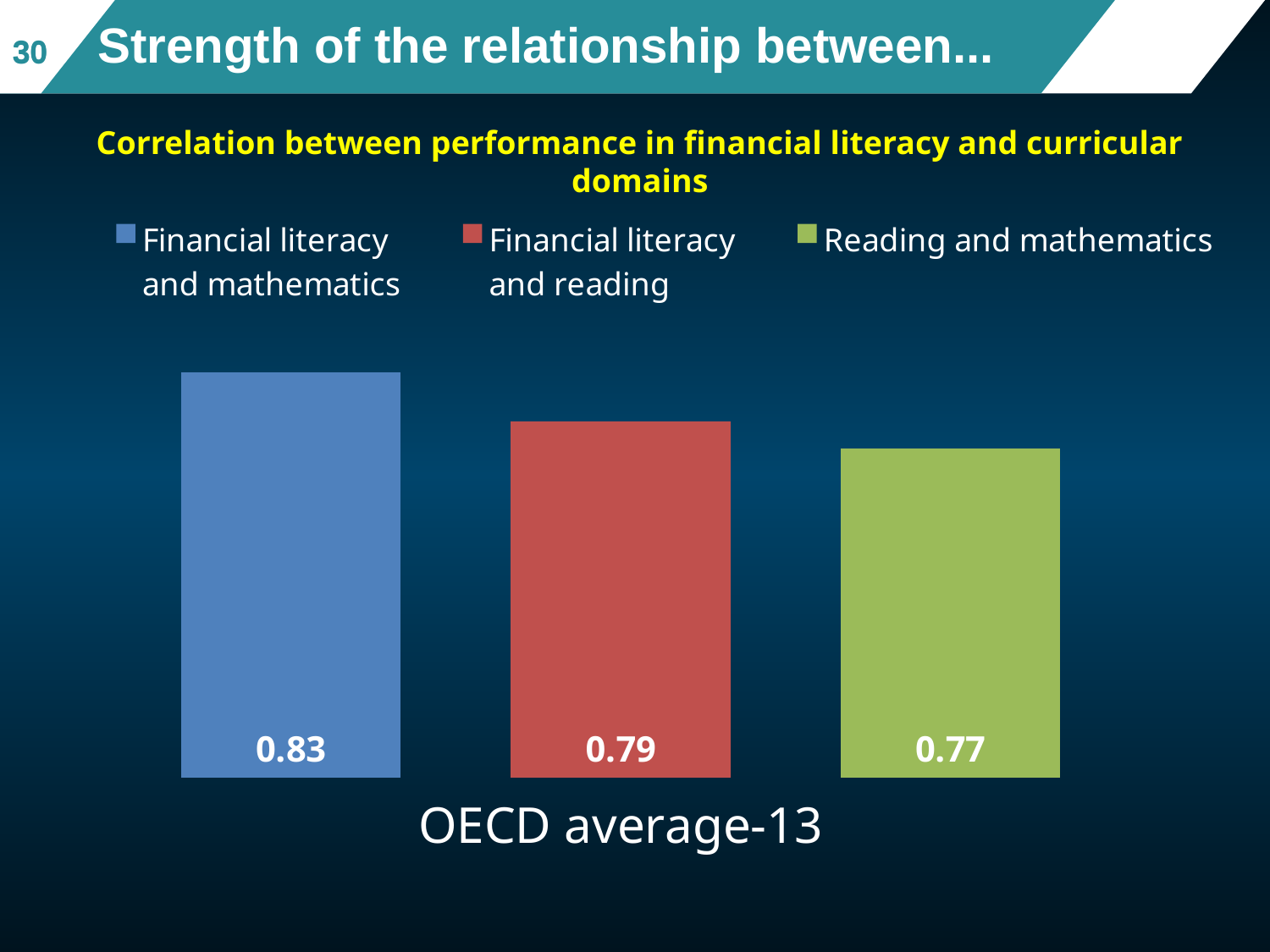
Which series has the lowest correlation value? Reading and mathematics What is the difference between the correlation for Financial literacy and mathematics and the correlation for Reading and mathematics? 0.06 How many series does the legend list? 3 Which series has the highest correlation value? Financial literacy and mathematics What is the correlation value for Financial literacy and reading? 0.79 Which is larger: the correlation for Financial literacy and reading or for Reading and mathematics? Financial literacy and reading What is the title of the chart? Correlation between performance in financial literacy and curricular domains What kind of chart is shown on the slide? Bar chart What is the category label shown below the bars? OECD average-13 What is the difference between the correlation for Financial literacy and reading and the correlation for Reading and mathematics? 0.02 What is the correlation value for Reading and mathematics? 0.77 What is the correlation value for Financial literacy and mathematics? 0.83